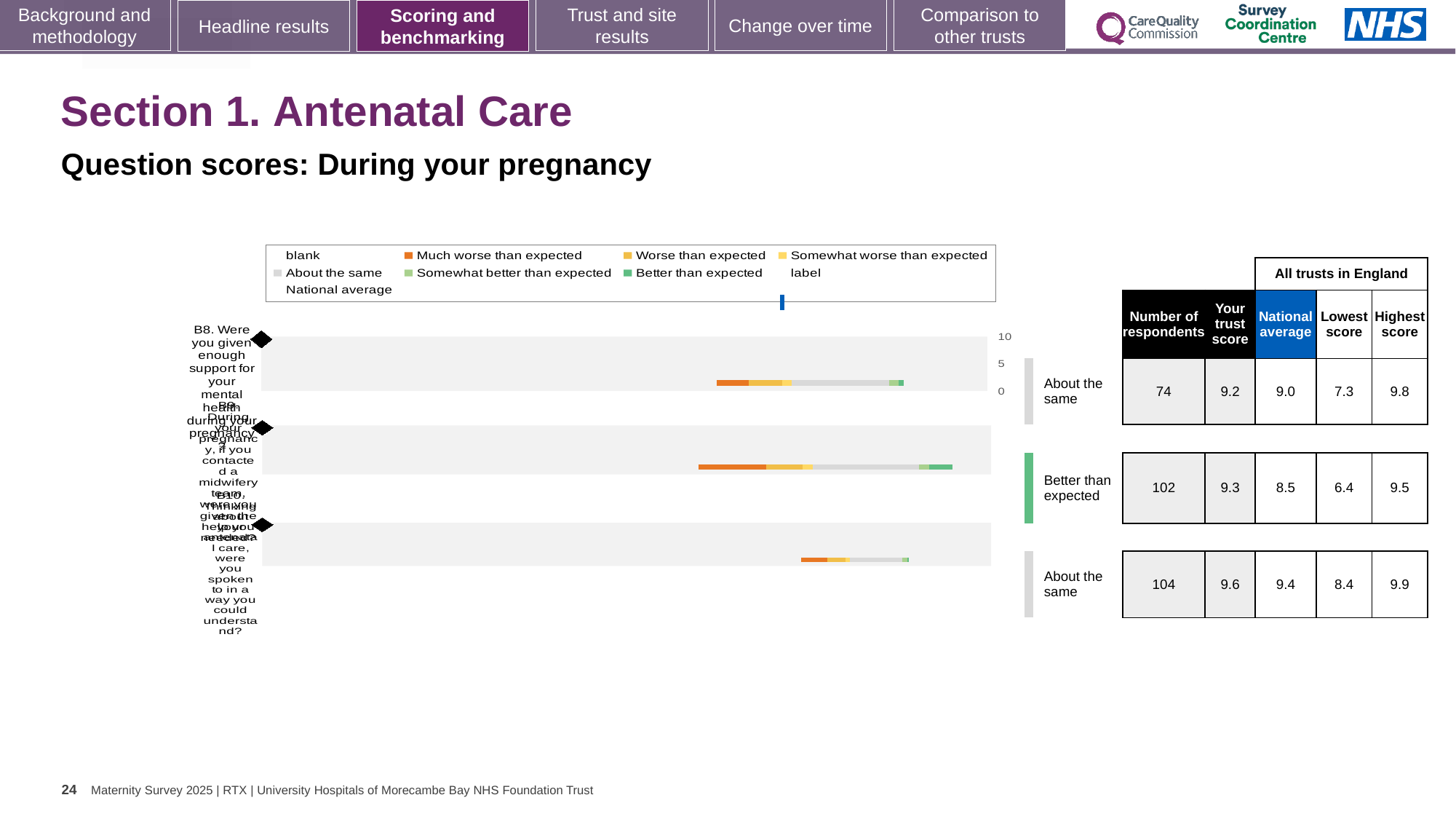
What kind of chart is shown on the slide? bar chart Which row has the highest trust score in the table? B10 (third row), 9.6 How many question rows are plotted in the chart? 3 Which is larger for the first row (B8): the trust score or the national average? trust score (9.2) In the table, what is the number of respondents for the first row (B8, mental health support)? 74 In the table, what is the national average for the third row (B10, spoken to in a way you could understand)? 9.4 Which row has the lowest number of respondents in the table? B8 (first row), 74 What is the difference between the trust score and the national average for the second row (B9)? 0.8 In the table, what is the trust score for the second row (B9, midwifery team help)? 9.3 In the table, what is the lowest score for the second row (B9)? 6.4 In the table, what is the highest score for the third row (B10)? 9.9 Which benchmark category is shown for the second row (B9)? Better than expected